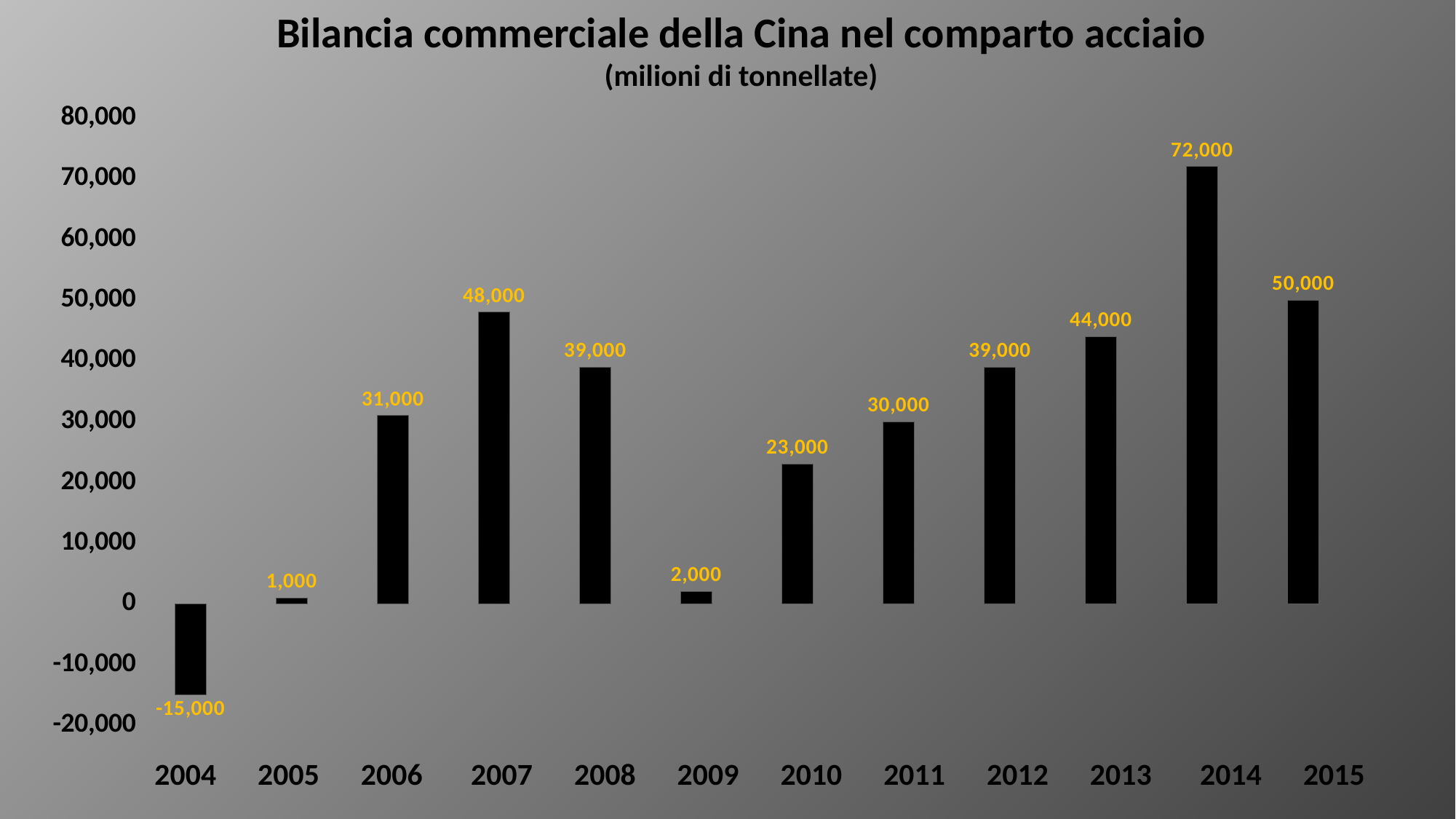
Which year has the highest value? 2014 What is the title of the chart? Bilancia commerciale della Cina nel comparto acciaio What is the value for 2004? -15,000 What kind of chart is shown on the slide? bar chart What is the value for 2009? 2,000 Which year has the lowest value? 2004 What is the difference between the values for 2014 and 2015? 22,000 What is the difference between the values for 2007 and 2006? 17,000 Which is larger, the value for 2013 or the value for 2012? 2013 What is the value for 2014? 72,000 How many years are shown on the x axis? 12 Is the value for 2011 greater or less than 20,000? greater